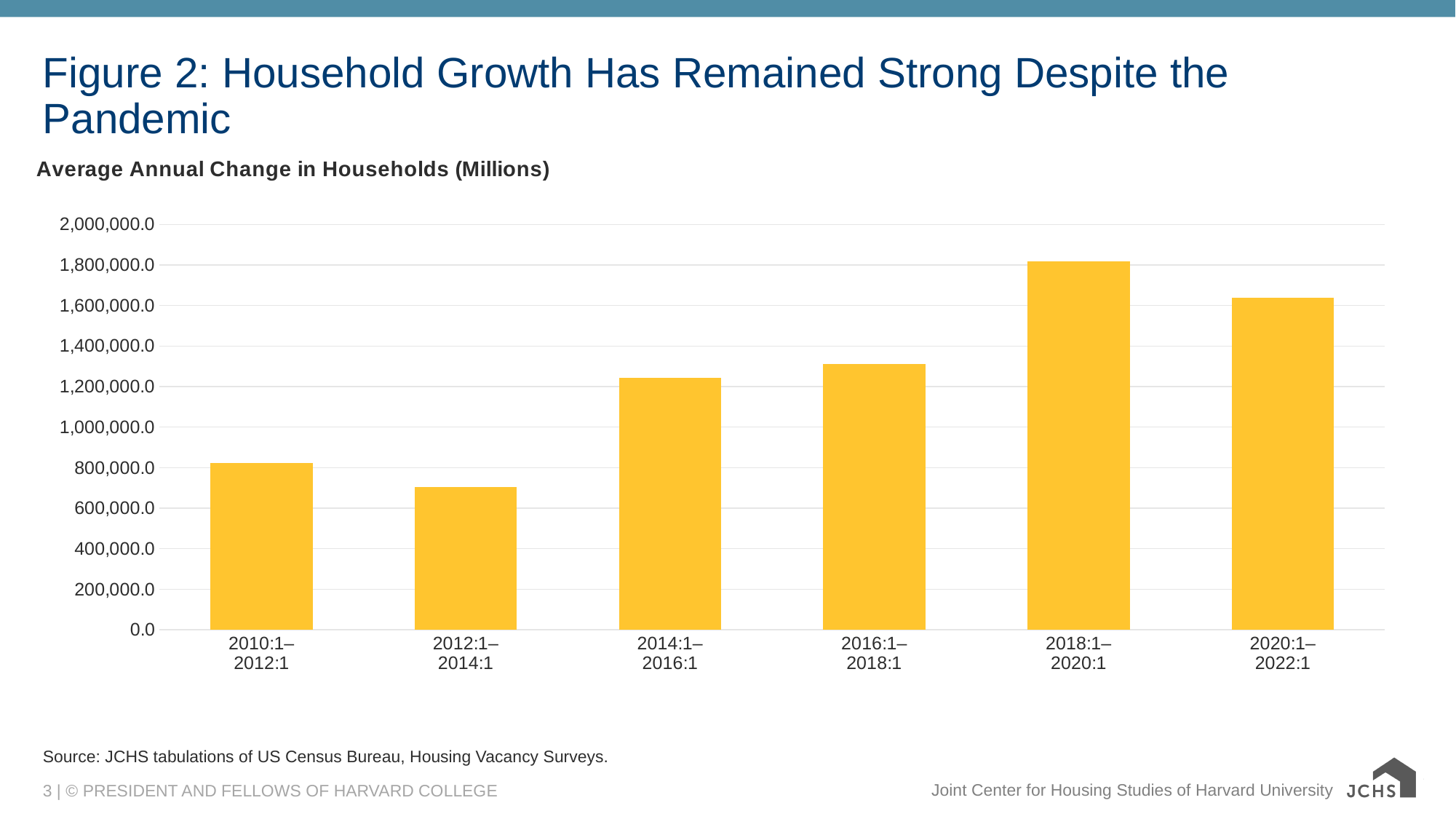
Which is larger, the value for 2018:1–2020:1 or the value for 2020:1–2022:1? 2018:1–2020:1 How many periods (bars) are shown on the chart? 6 Which period has the lowest average annual change in households? 2012:1–2014:1 Is the value for 2020:1–2022:1 greater or less than 1,600,000.0? greater What kind of chart is shown on the slide? bar chart Is the value for 2014:1–2016:1 greater or less than 1,400,000.0? less Which period has the highest average annual change in households? 2018:1–2020:1 What is the highest value shown on the vertical axis? 2,000,000.0 Is the value for 2012:1–2014:1 greater or less than 800,000.0? less What is the axis title or subtitle describing the plotted values? Average Annual Change in Households (Millions) Which is larger, the value for 2010:1–2012:1 or the value for 2012:1–2014:1? 2010:1–2012:1